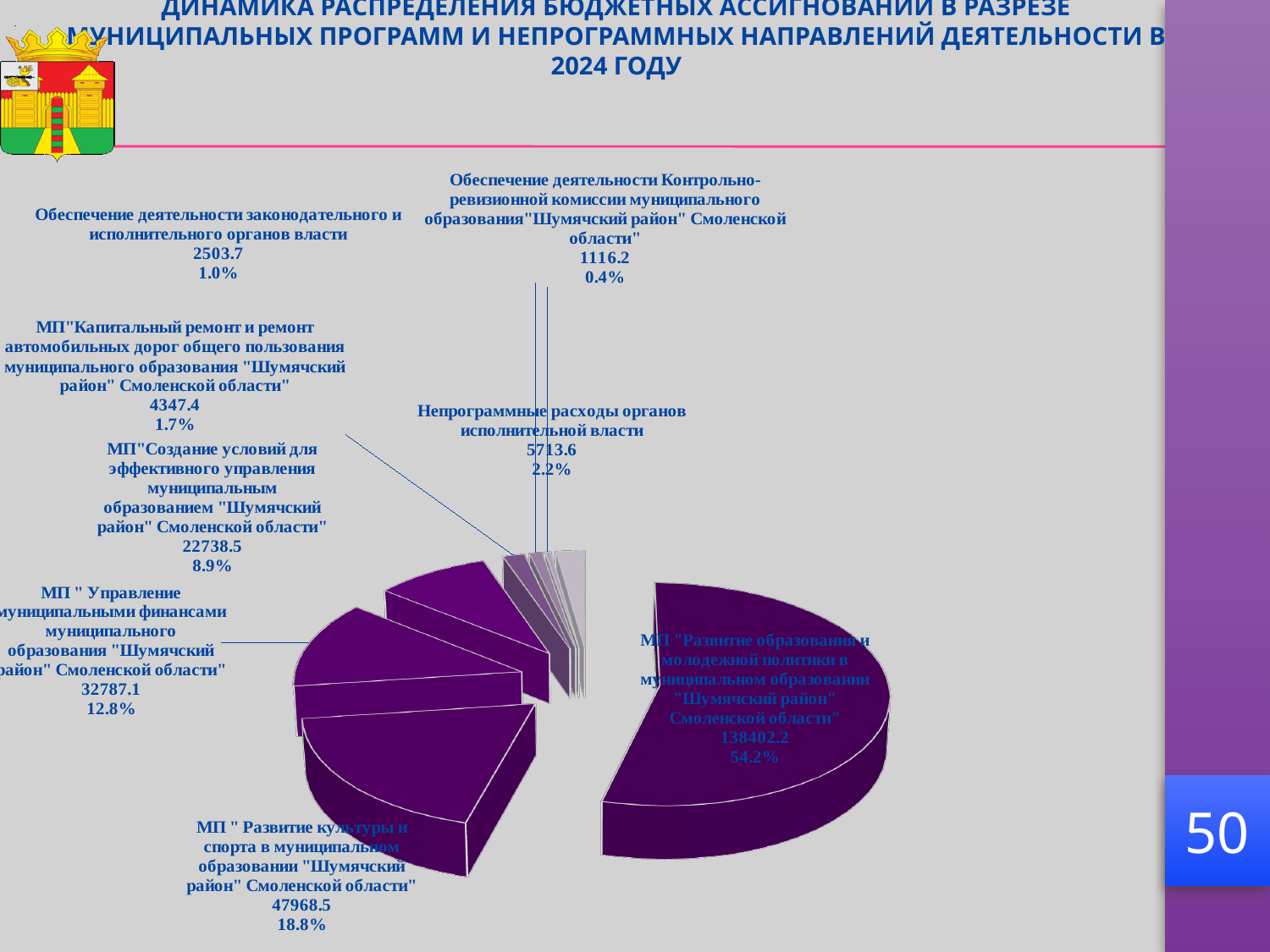
What is the difference between the values for МП "Развитие культуры и спорта" (47968.5) and МП "Управление муниципальными финансами" (32787.1)? 15181.4 What share of the pie does МП "Развитие культуры и спорта в муниципальном образовании "Шумячский район" Смоленской области" have? 18.8% What kind of chart is shown on the slide? pie chart What is the value shown for МП "Развитие образования и молодежной политики в муниципальном образовании "Шумячский район" Смоленской области"? 138402.2 Which is larger: the value for МП "Создание условий для эффективного управления муниципальным образованием "Шумячский район" Смоленской области" or the value for Непрограммные расходы органов исполнительной власти? МП "Создание условий для эффективного управления муниципальным образованием "Шумячский район" Смоленской области" What is the value shown for МП "Капитальный ремонт и ремонт автомобильных дорог общего пользования муниципального образования "Шумячский район" Смоленской области"? 4347.4 Which category has the largest slice of the pie? МП "Развитие образования и молодежной политики в муниципальном образовании "Шумячский район" Смоленской области" How many slices (categories) does the pie chart have? 8 Which category has the smallest slice of the pie? Обеспечение деятельности Контрольно-ревизионной комиссии муниципального образования "Шумячский район" Смоленской области" What is the value shown for МП "Управление муниципальными финансами муниципального образования "Шумячский район" Смоленской области"? 32787.1 What percentage is shown for Непрограммные расходы органов исполнительной власти? 2.2% What percentage is shown for Обеспечение деятельности законодательного и исполнительного органов власти? 1.0%